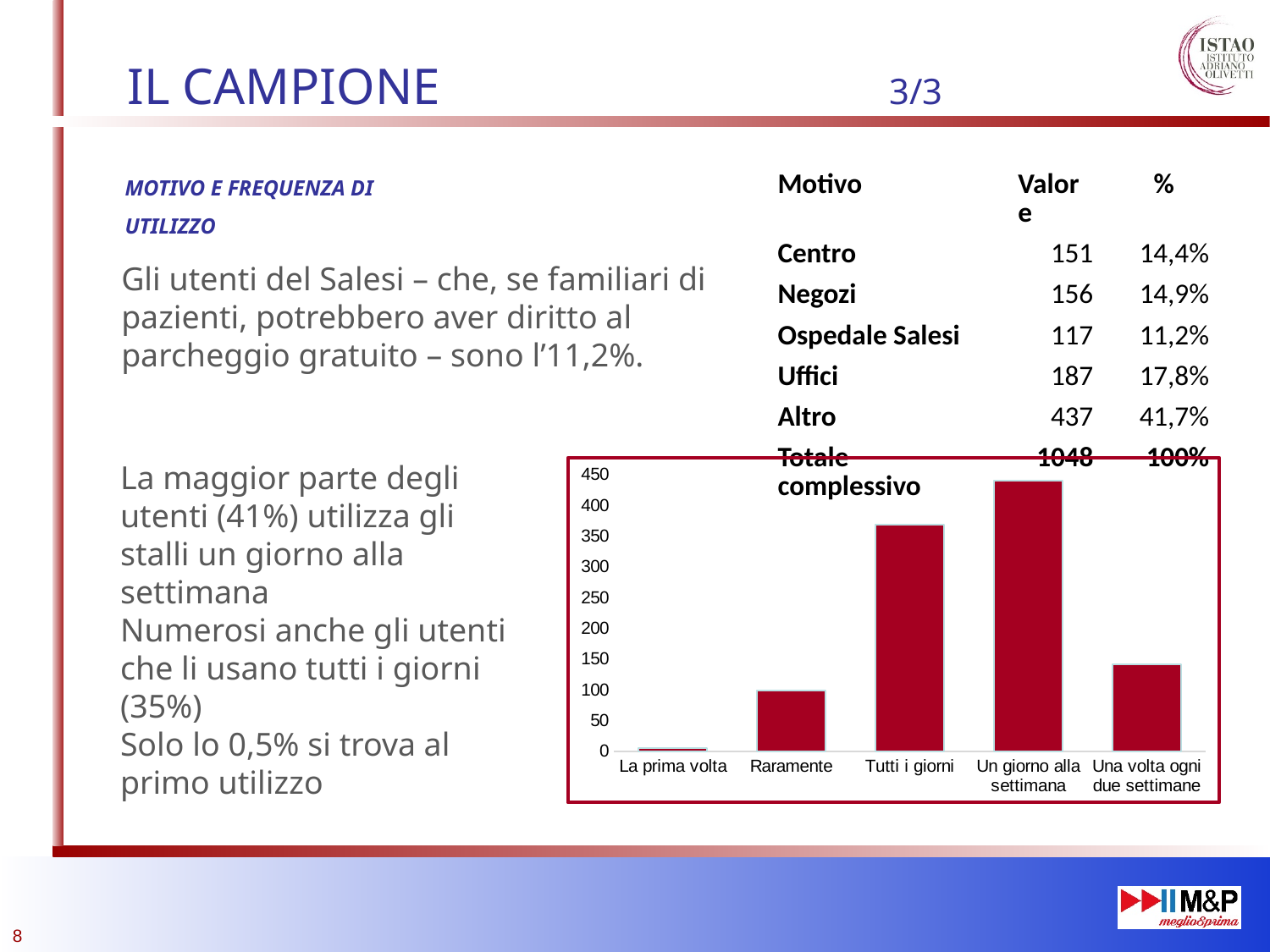
Which category has the highest bar in the chart? Un giorno alla settimana Which is larger, the bar for Tutti i giorni or the bar for Una volta ogni due settimane? Tutti i giorni What is the highest value shown on the y axis of the chart? 450 Which category has the lowest bar in the chart? La prima volta Which is larger, the bar for Raramente or the bar for Una volta ogni due settimane? Una volta ogni due settimane Is the value for Tutti i giorni greater or less than 300? greater Is the value for Raramente greater or less than 150? less How many categories are shown on the x axis of the bar chart? 5 Is the value for La prima volta greater or less than 50? less What kind of chart is shown on the slide? bar chart